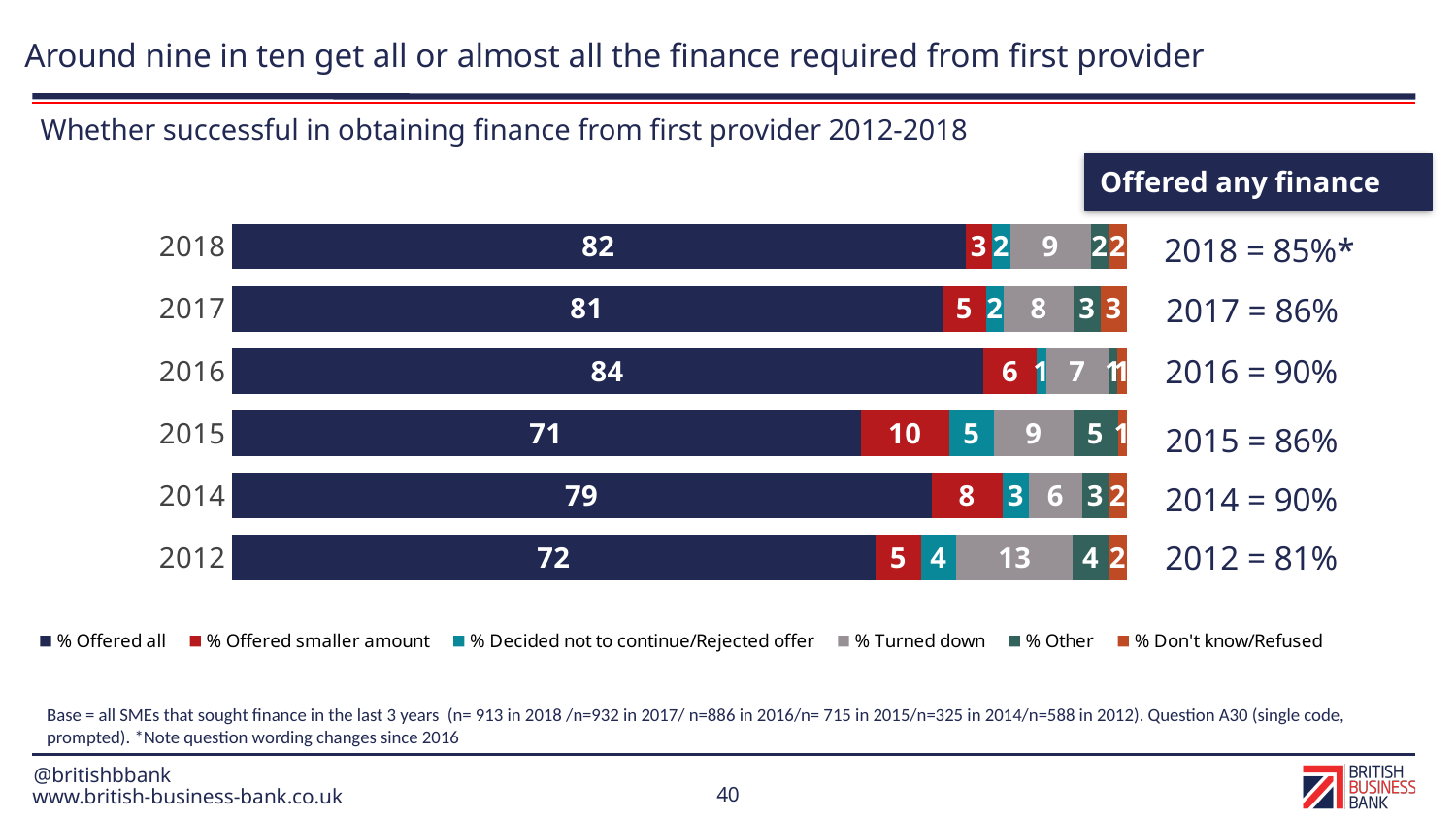
What is the value for % Offered all in 2018? 82 What is the difference between the % Offered all values for 2016 and 2015? 13 What type of chart is shown on the slide? stacked bar chart What is the value for % Turned down in 2012? 13 How many years are shown on the chart? 6 What is the value for % Offered smaller amount in 2015? 10 Which year has the lowest value for % Offered all? 2015 How many series does the legend list? 6 What is the title of the chart? Whether successful in obtaining finance from first provider 2012-2018 Which is larger, the % Turned down value for 2012 or for 2017? 2012 According to the 'Offered any finance' box, what was the percentage offered any finance in 2012? 81% Which year has the highest value for % Offered all? 2016